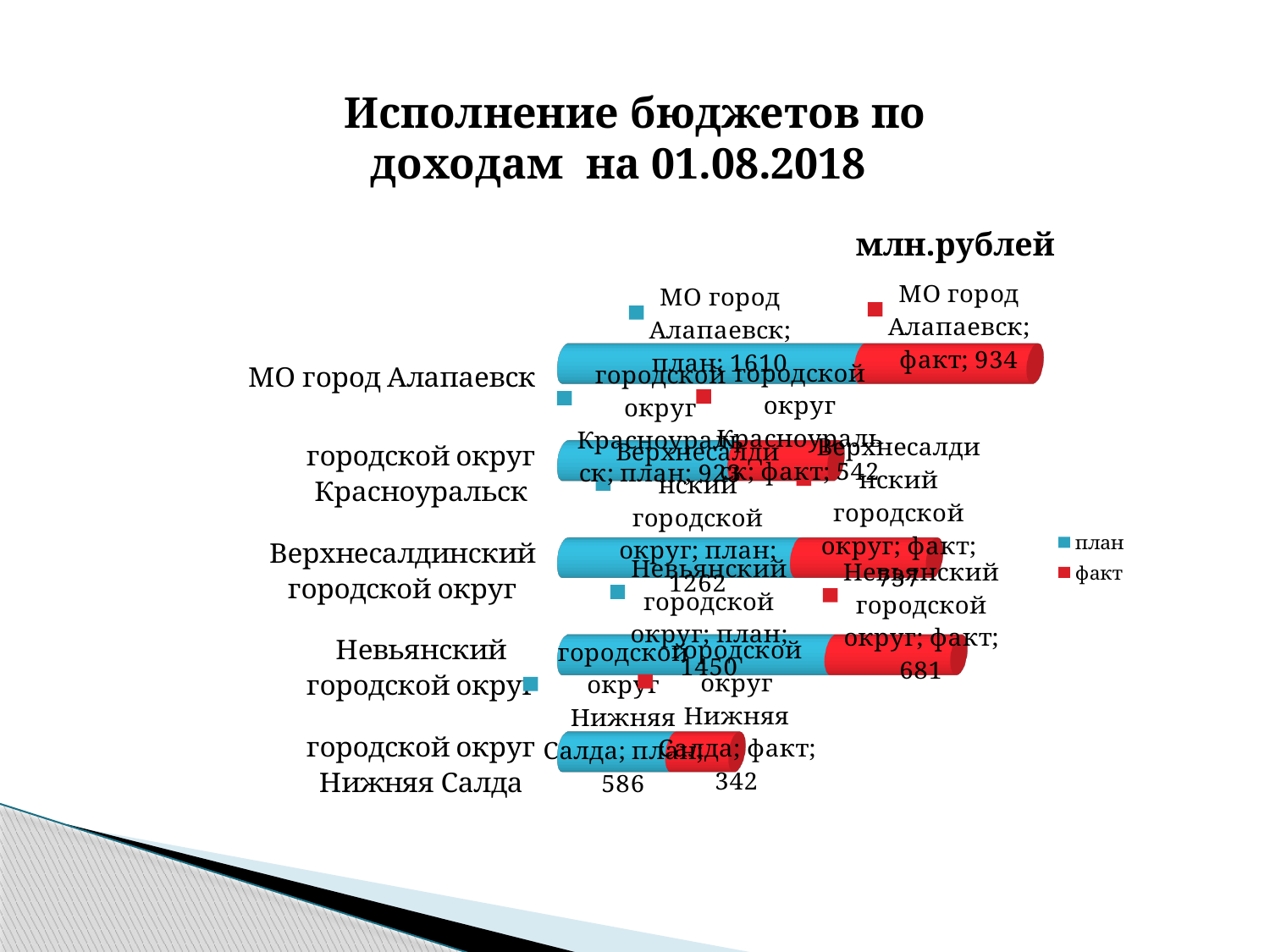
What is the план value for Невьянский городской округ? 1450 Which category has the lowest план value? городской округ Нижняя Салда Which category has the highest план value? МО город Алапаевск How many categories are shown in the chart? 5 What is the факт value for городской округ Красноуральск? 542 What is the план value for МО город Алапаевск? 1610 What is the difference between the план and факт values for МО город Алапаевск? 676 What is the факт value for МО город Алапаевск? 934 How many series does the legend list? 2 Which has the larger план value: Невьянский городской округ or Верхнесалдинский городской округ? Невьянский городской округ What kind of chart is shown on the slide? bar chart What is the факт value for городской округ Нижняя Салда? 342